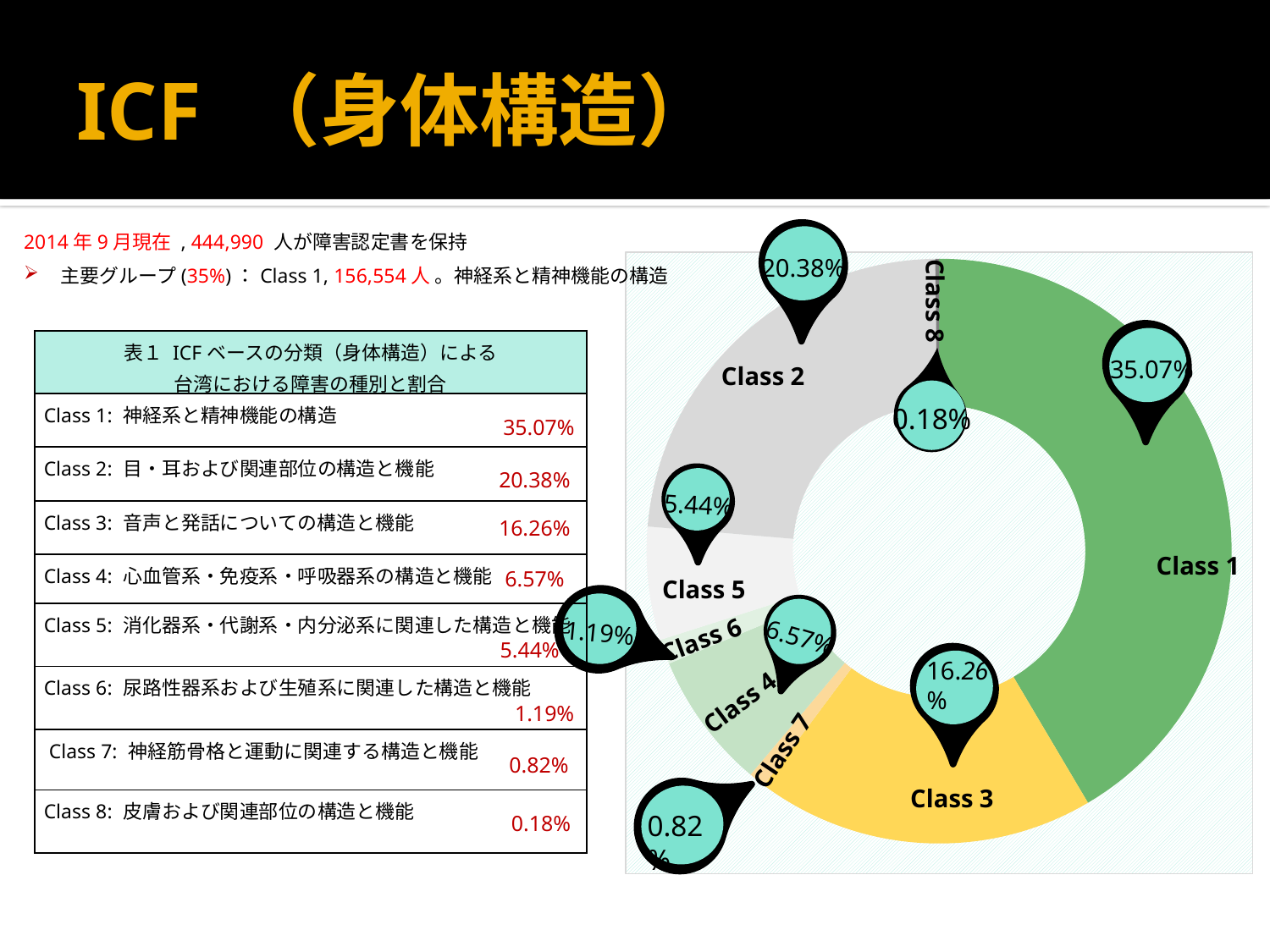
What is the difference between the values for Class 1 and Class 2 in the doughnut chart? 14.69% What is the value shown for Class 1 in the doughnut chart? 35.07% What is the value shown for Class 2 in the doughnut chart? 20.38% Which class has the largest share in the doughnut chart? Class 1 What is the value shown for Class 4 in the doughnut chart? 6.57% Which is larger in the doughnut chart, the value for Class 3 or the value for Class 4? Class 3 Which class has the smallest share in the doughnut chart? Class 8 How many classes (segments) are shown in the doughnut chart? 8 What kind of chart is shown on the slide? Doughnut chart What is the value shown for Class 3 in the doughnut chart? 16.26% What colour is the Class 3 segment in the doughnut chart? Yellow What is the value shown for Class 8 in the doughnut chart? 0.18%